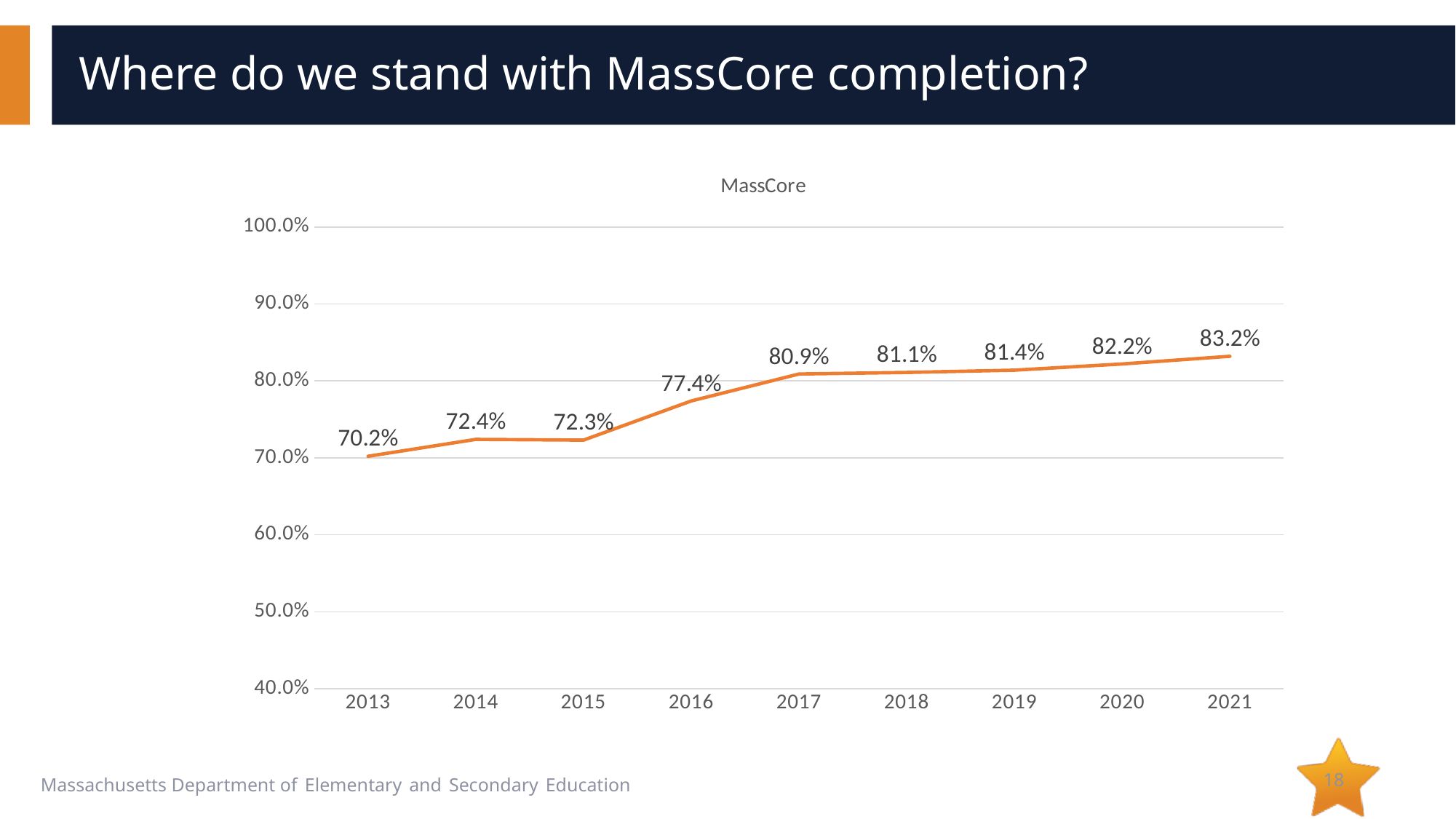
What is the MassCore completion value for 2017? 80.9% How many years are plotted on the chart? 9 Is the MassCore value for 2016 greater or less than 80.0%? less What kind of chart is shown on the slide? line chart Do the MassCore values generally rise or fall from 2013 to 2021? rise What is the difference between the MassCore values for 2021 and 2013? 13.0% What is the MassCore completion value for 2021? 83.2% Which year has the highest MassCore completion value? 2021 Which year has the larger MassCore value, 2014 or 2016? 2016 Which year has the lowest MassCore completion value? 2013 What is the MassCore completion value for 2013? 70.2% What is the difference between the MassCore values for 2017 and 2016? 3.5%